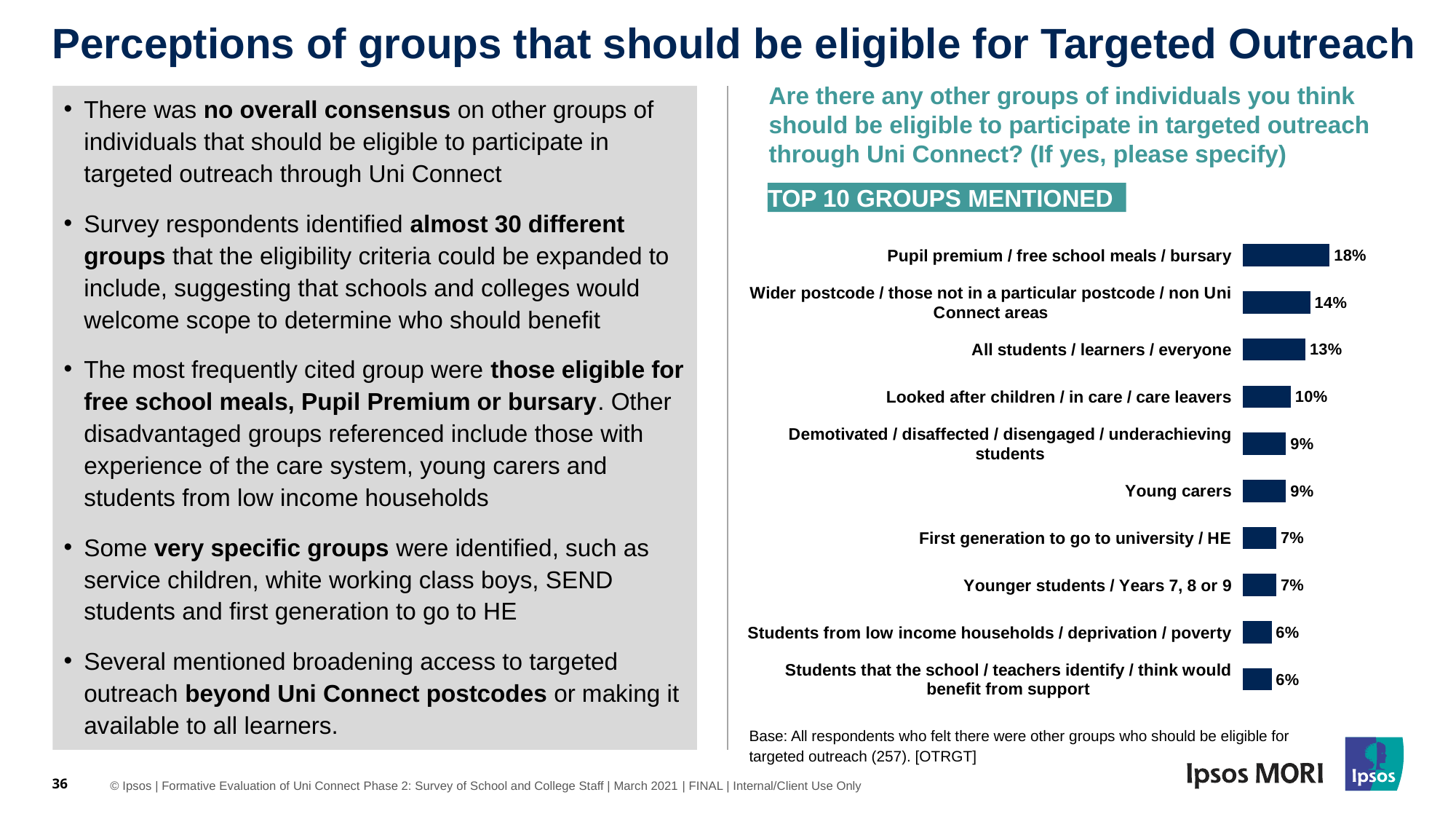
What is the value for Younger students / Years 7, 8 or 9? 7% What type of chart is used to show the top 10 groups mentioned? Bar chart Which group has the highest percentage in the chart? Pupil premium / free school meals / bursary What is the value for Looked after children / in care / care leavers? 10% How many groups are shown in the chart? 10 What is the heading shown directly above the chart? TOP 10 GROUPS MENTIONED What percentage of respondents mentioned Pupil premium / free school meals / bursary? 18% What percentage is shown for Young carers? 9% What is the base size stated for the chart? 257 What is the difference in percentage points between Pupil premium / free school meals / bursary and All students / learners / everyone? 5 Which is larger: the value for All students / learners / everyone or the value for First generation to go to university / HE? All students / learners / everyone What is the difference between the values for Wider postcode / those not in a particular postcode / non Uni Connect areas and Looked after children / in care / care leavers? 4%